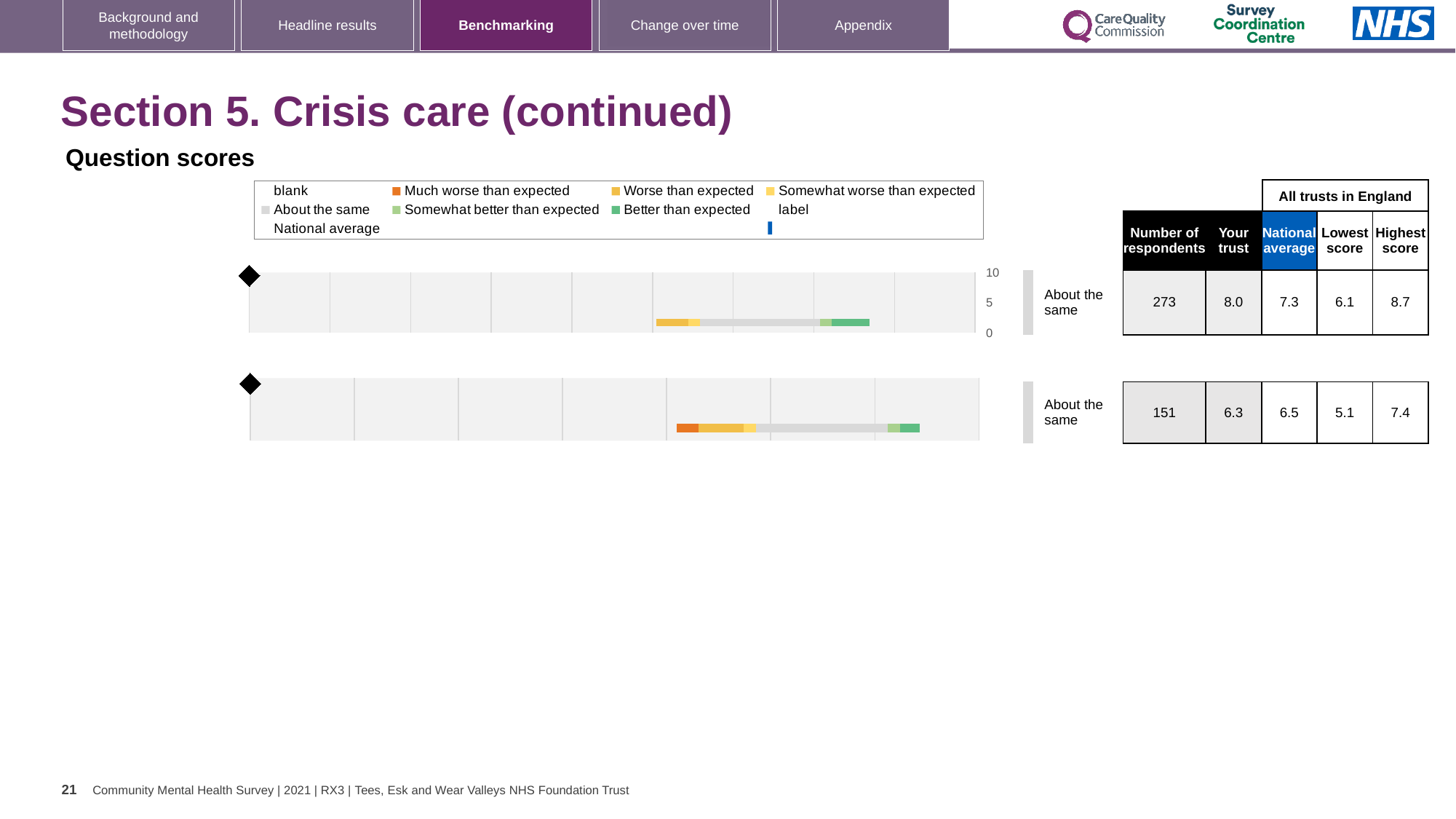
What kind of chart is used to show the question scores on this slide? Bar chart For the bottom chart, how many respondents are listed? 151 For the top chart, what is the highest score among all trusts in England? 8.7 For the bottom chart, what is the lowest score among all trusts in England? 5.1 For the top chart, how many respondents are listed? 273 For the bottom chart, which is larger: the 'Your trust' score or the national average? National average For the top chart, which is larger: the 'Your trust' score or the national average? Your trust For the top chart, what is the national average score? 7.3 For the top chart, what is the 'Your trust' score shown in the table? 8.0 For the top chart, what is the difference between the highest score and the lowest score among all trusts in England? 2.6 For the bottom chart, what is the 'Your trust' score? 6.3 What benchmark category is shown next to the bottom chart? About the same